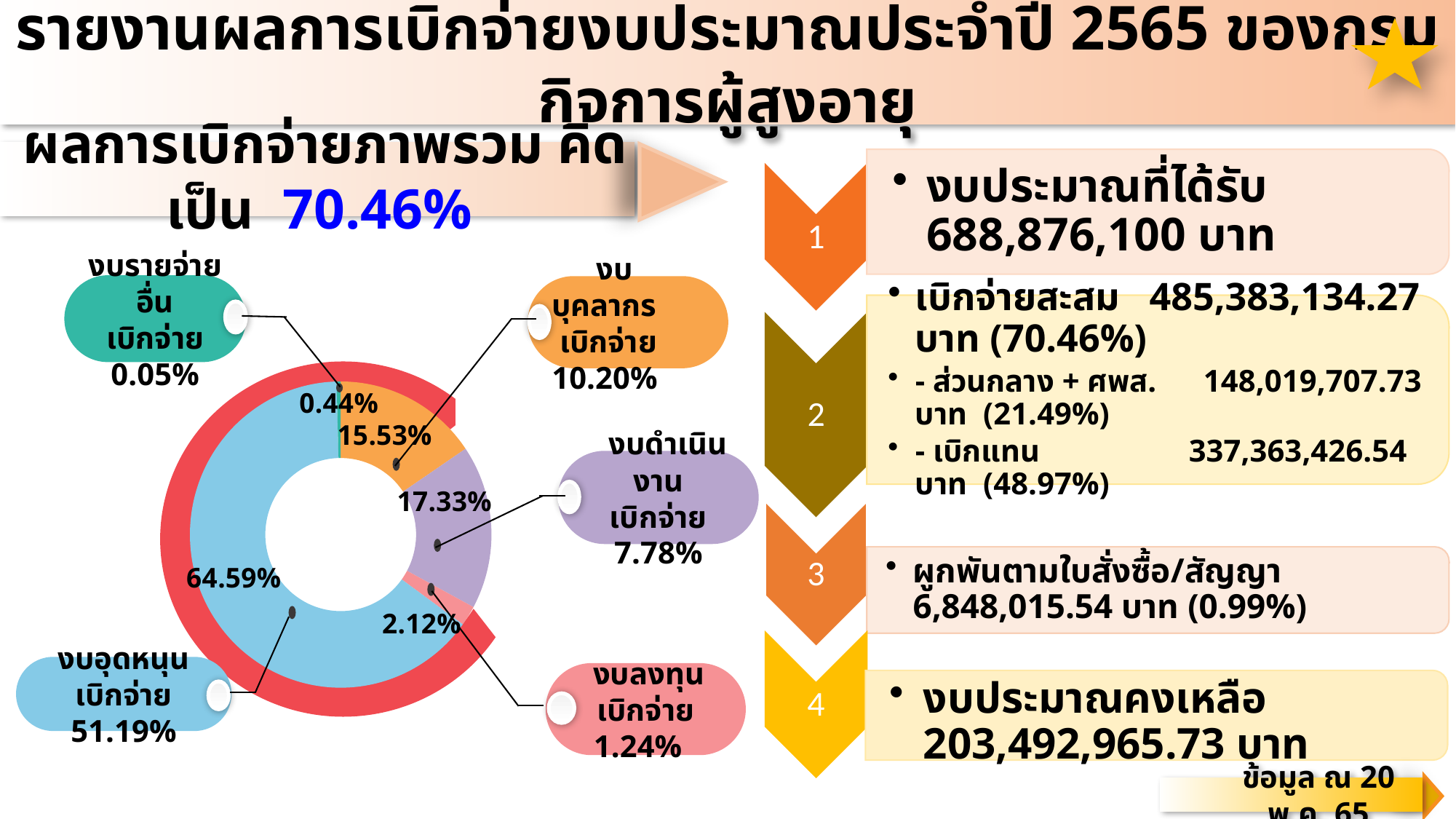
What value is labelled on the purple slice of the doughnut chart? 17.33% Which is larger in the doughnut chart, the purple slice or the orange slice? the purple slice (17.33%) Which slice of the doughnut chart is the smallest? the green slice (งบรายจ่ายอื่น), 0.44% According to the callout linked to the blue slice, what is the disbursement rate for งบอุดหนุน? 51.19% What is the difference between the purple slice (17.33%) and the orange slice (15.53%) in the doughnut chart? 1.80% What value is labelled on the orange slice of the doughnut chart? 15.53% How many slices does the doughnut chart have? 5 What overall disbursement percentage is shown in blue text above the doughnut chart? 70.46% What kind of chart is shown on the left of the slide? doughnut (pie) chart Which slice of the doughnut chart is the largest? the blue slice (งบอุดหนุน), 64.59% What value is labelled on the pink slice of the doughnut chart? 2.12% According to the callout linked to the orange slice, what is the disbursement rate for งบบุคลากร? 10.20%